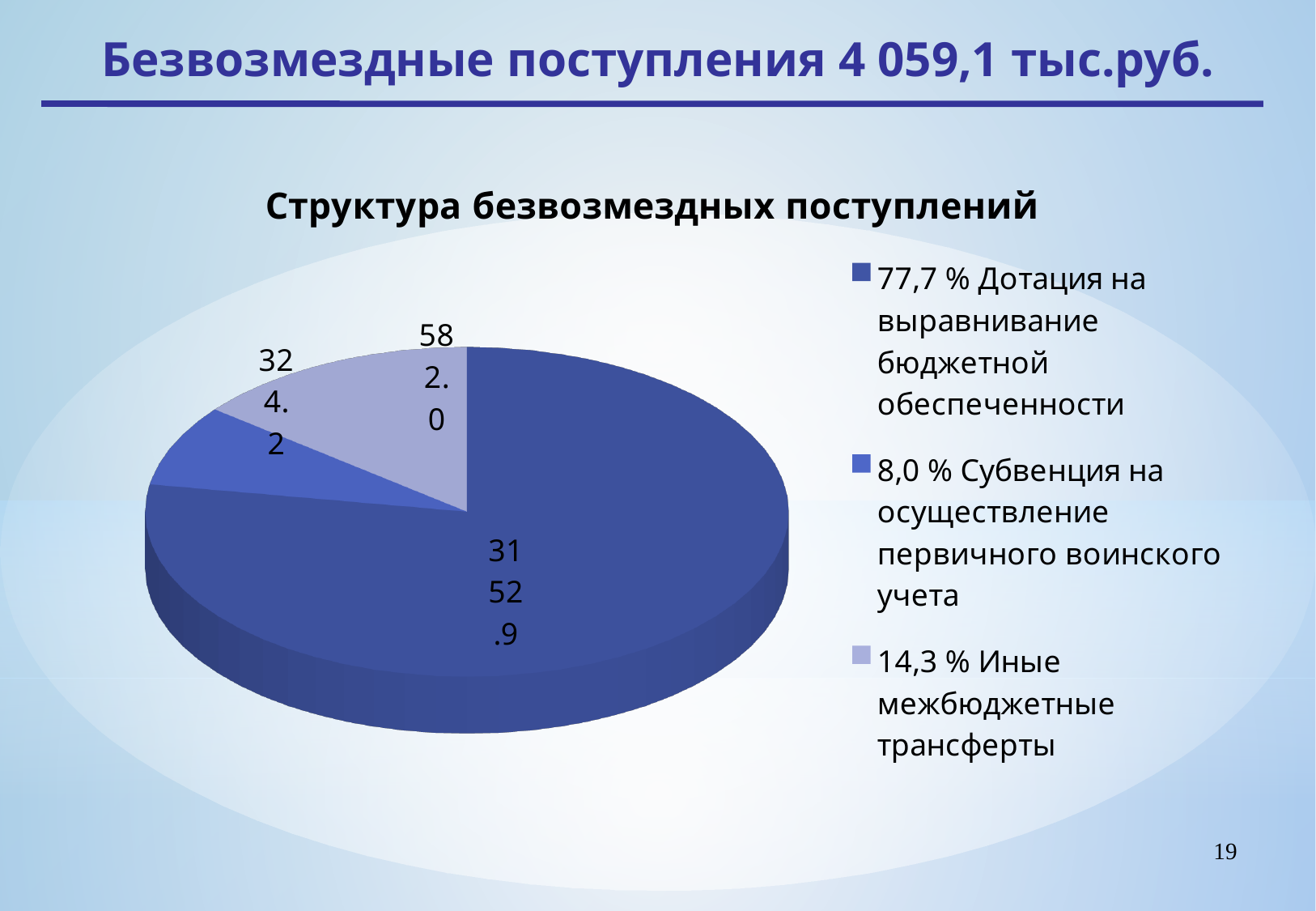
What value is shown for Дотация на выравнивание бюджетной обеспеченности? 3152.9 What value is shown for Субвенция на осуществление первичного воинского учета? 324.2 Which category has the largest slice of the pie? Дотация на выравнивание бюджетной обеспеченности Which is larger: the value for Иные межбюджетные трансферты or the value for Субвенция на осуществление первичного воинского учета? Иные межбюджетные трансферты What share of the pie does Иные межбюджетные трансферты represent? 14,3 % What kind of chart is shown on the slide? pie chart Which category has the smallest slice of the pie? Субвенция на осуществление первичного воинского учета What is the title of the chart? Структура безвозмездных поступлений What is the difference between the values for Иные межбюджетные трансферты and Субвенция на осуществление первичного воинского учета? 257.8 How many slices does the pie chart have? 3 How many entries does the legend list? 3 What value is shown for Иные межбюджетные трансферты? 582.0